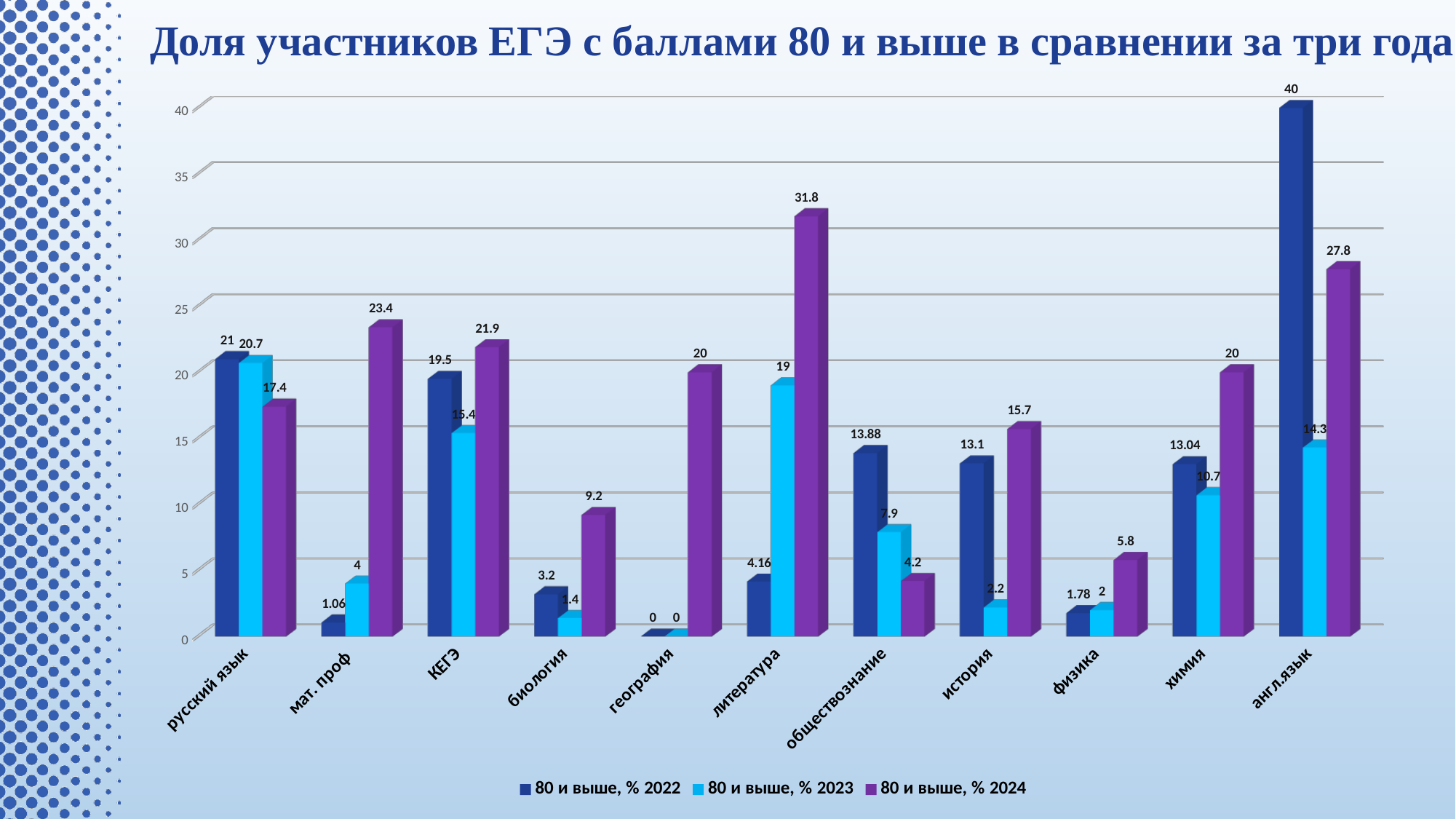
How many categories are shown on the x axis? 11 Which category has the lowest value in the series "80 и выше, % 2022"? география What is the value for обществознание in the series "80 и выше, % 2023"? 7.9 What is the value for литература in the series "80 и выше, % 2024"? 31.8 Which category has the highest value in the series "80 и выше, % 2024"? литература What is the title of the chart? Доля участников ЕГЭ с баллами 80 и выше в сравнении за три года Is the value for КЕГЭ in the series "80 и выше, % 2024" greater or less than 20? greater Which is larger for химия: the 2022 value or the 2023 value? 2022 value What kind of chart is shown on the slide? bar chart How many series does the legend list? 3 What is the value for англ.язык in the series "80 и выше, % 2022"? 40 What is the difference between the 2024 and 2022 values for мат. проф? 22.34